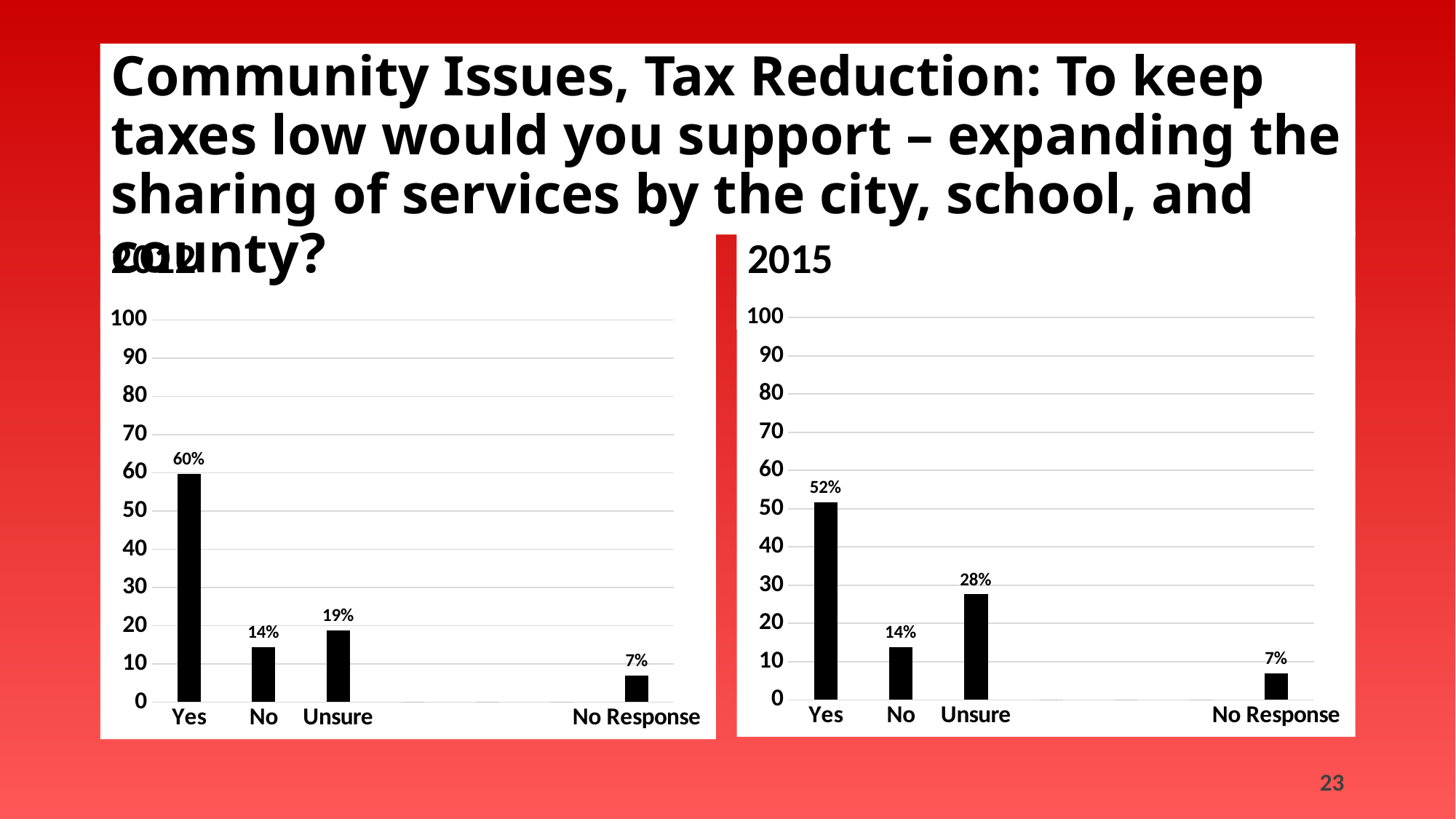
How many labeled categories does the 2015 chart show? 4 In the left chart, what is the value for Yes? 60% What kind of chart is the 2015 chart? bar chart In the left chart, what is the difference between the values for Unsure and No? 5% In the left chart, which category has the highest value? Yes In the 2015 chart, what is the difference between the values for Yes and Unsure? 24% In the 2015 chart, which is larger, the value for No or the value for Unsure? Unsure In the left chart, what is the value for No Response? 7% In the 2015 chart, what is the value for Yes? 52% In the left chart, is the value for Yes greater or less than 50? greater In the 2015 chart, what is the value for Unsure? 28% In the 2015 chart, which category has the lowest value? No Response